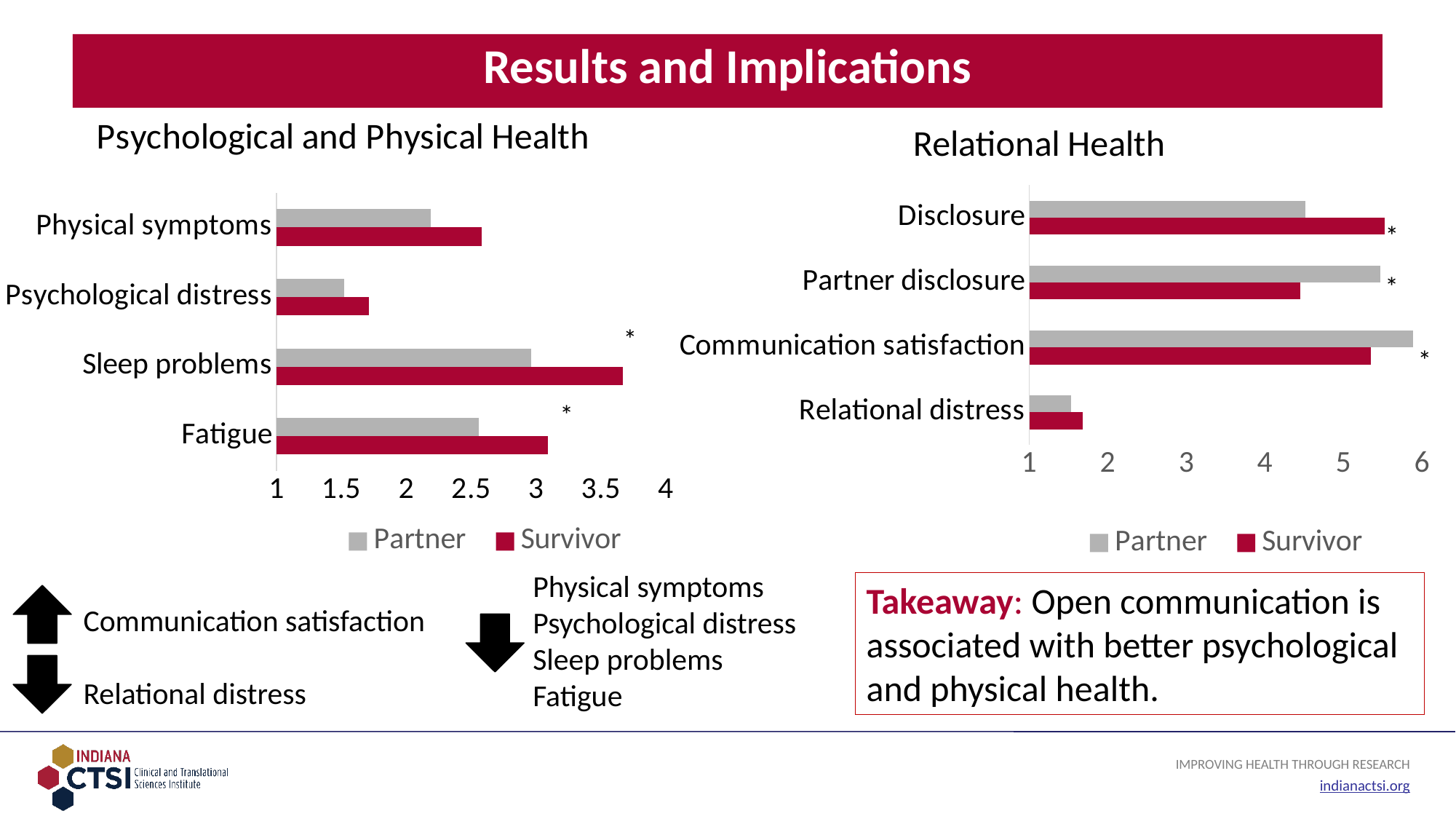
In the Psychological and Physical Health chart, which category has the highest Survivor value? Sleep problems What kind of chart is the Psychological and Physical Health chart? Bar chart In the Psychological and Physical Health chart, is the Survivor value for Sleep problems greater or less than 3.5? greater In the Relational Health chart, is the Partner value for Communication satisfaction greater or less than 5? greater In the Psychological and Physical Health chart, is the Partner value for Physical symptoms greater or less than 2.5? less In the Relational Health chart, which series is shown in grey? Partner In the Psychological and Physical Health chart, which category has the lowest Partner value? Psychological distress In the Relational Health chart, which category has the highest Partner value? Communication satisfaction In the Relational Health chart, for Disclosure, which is larger: the Partner value or the Survivor value? Survivor In the Relational Health chart, which category has the lowest Survivor value? Relational distress How many series does the legend of the Psychological and Physical Health chart list? 2 How many categories are shown in the Relational Health chart? 4